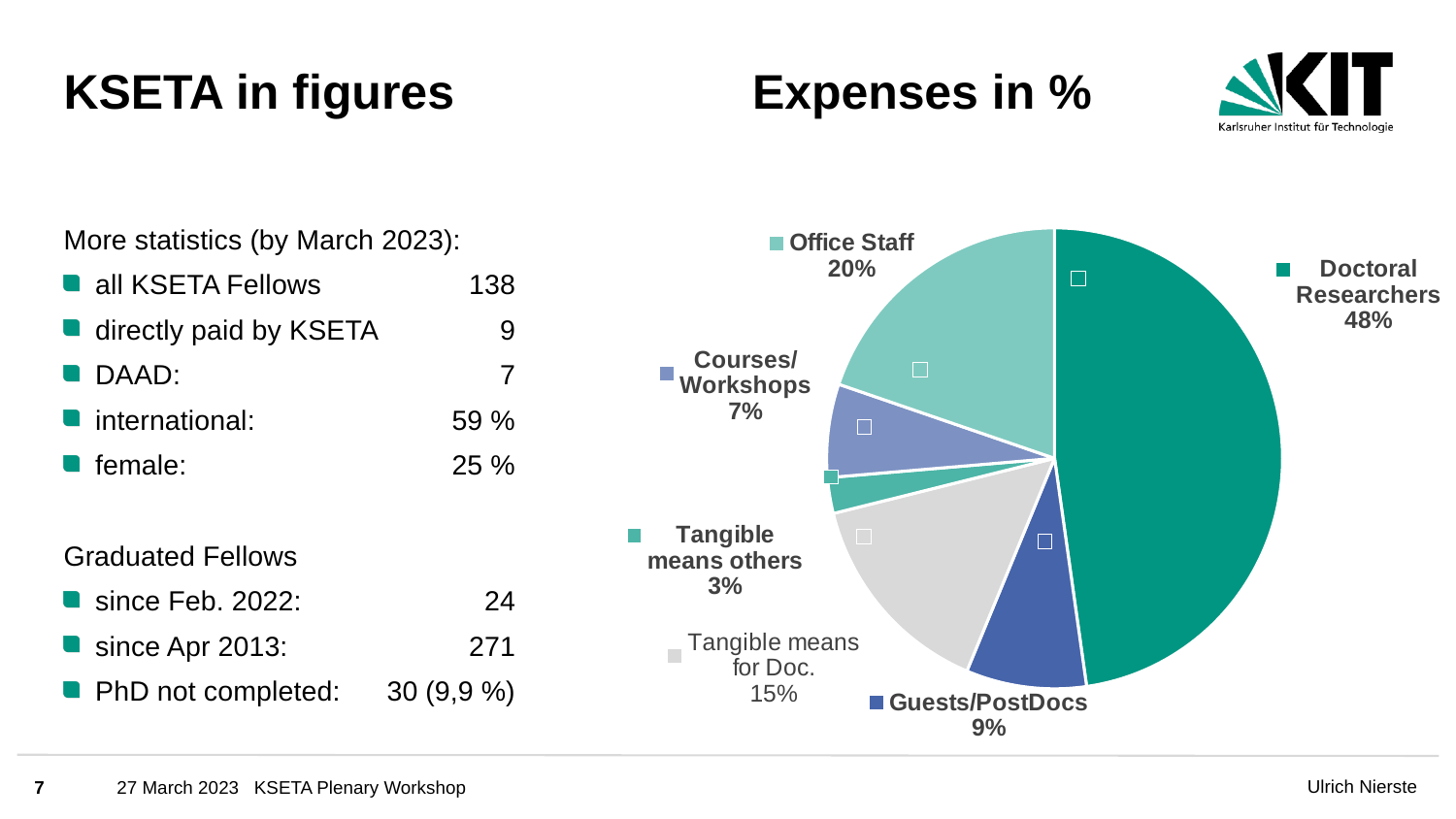
Which is larger, the share for Office Staff or the share for Tangible means for Doc.? Office Staff What is the difference between the Doctoral Researchers share and the Office Staff share? 28% What is the title of the chart? Expenses in % What share of expenses goes to Doctoral Researchers? 48% What share of expenses goes to Guests/PostDocs? 9% What kind of chart is shown on the slide? pie chart Which category has the smallest share of expenses? Tangible means others What share of expenses goes to Courses/Workshops? 7% Which category has the largest share of expenses? Doctoral Researchers What share of expenses goes to Office Staff? 20% What share of expenses goes to Tangible means for Doc.? 15% How many slices does the pie chart have? 6